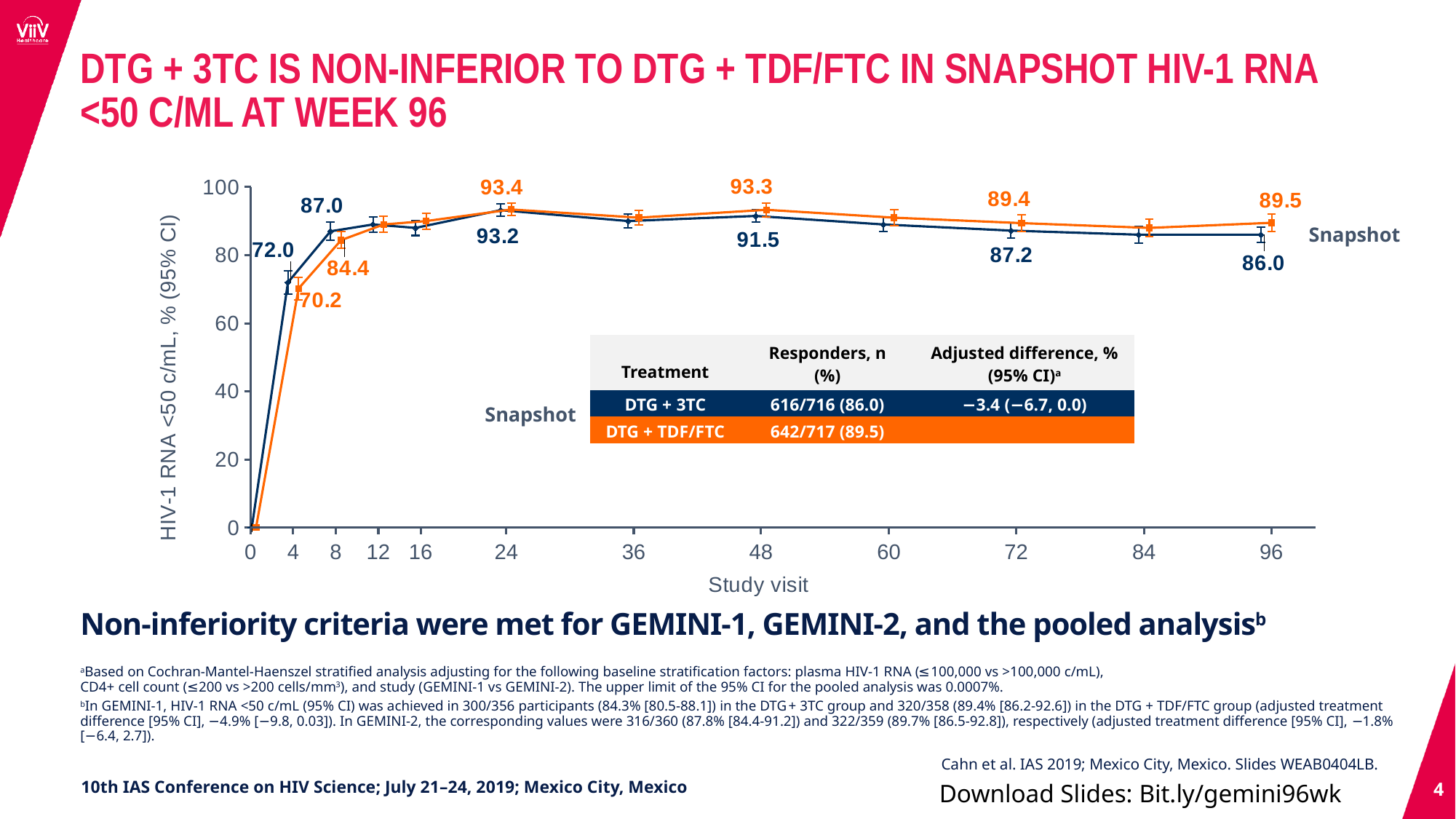
What is the value for DTG + TDF/FTC at week 8? 84.4 How many study visits are marked on the x axis? 12 What is the label on the y axis of the chart? HIV-1 RNA <50 c/mL, % (95% CI) At week 4, which treatment has the higher value, DTG + 3TC or DTG + TDF/FTC? DTG + 3TC Is the value for DTG + 3TC at week 12 greater or less than 80? greater What is the difference between the DTG + TDF/FTC and DTG + 3TC values at week 96? 3.5 Does the DTG + 3TC line rise or fall from week 24 to week 96? fall What is the value for DTG + TDF/FTC at week 96? 89.5 At week 48, which treatment has the higher value, DTG + 3TC or DTG + TDF/FTC? DTG + TDF/FTC What kind of chart is shown on the slide? line chart What is the value for DTG + 3TC at week 96? 86.0 What is the value for DTG + 3TC at week 4? 72.0